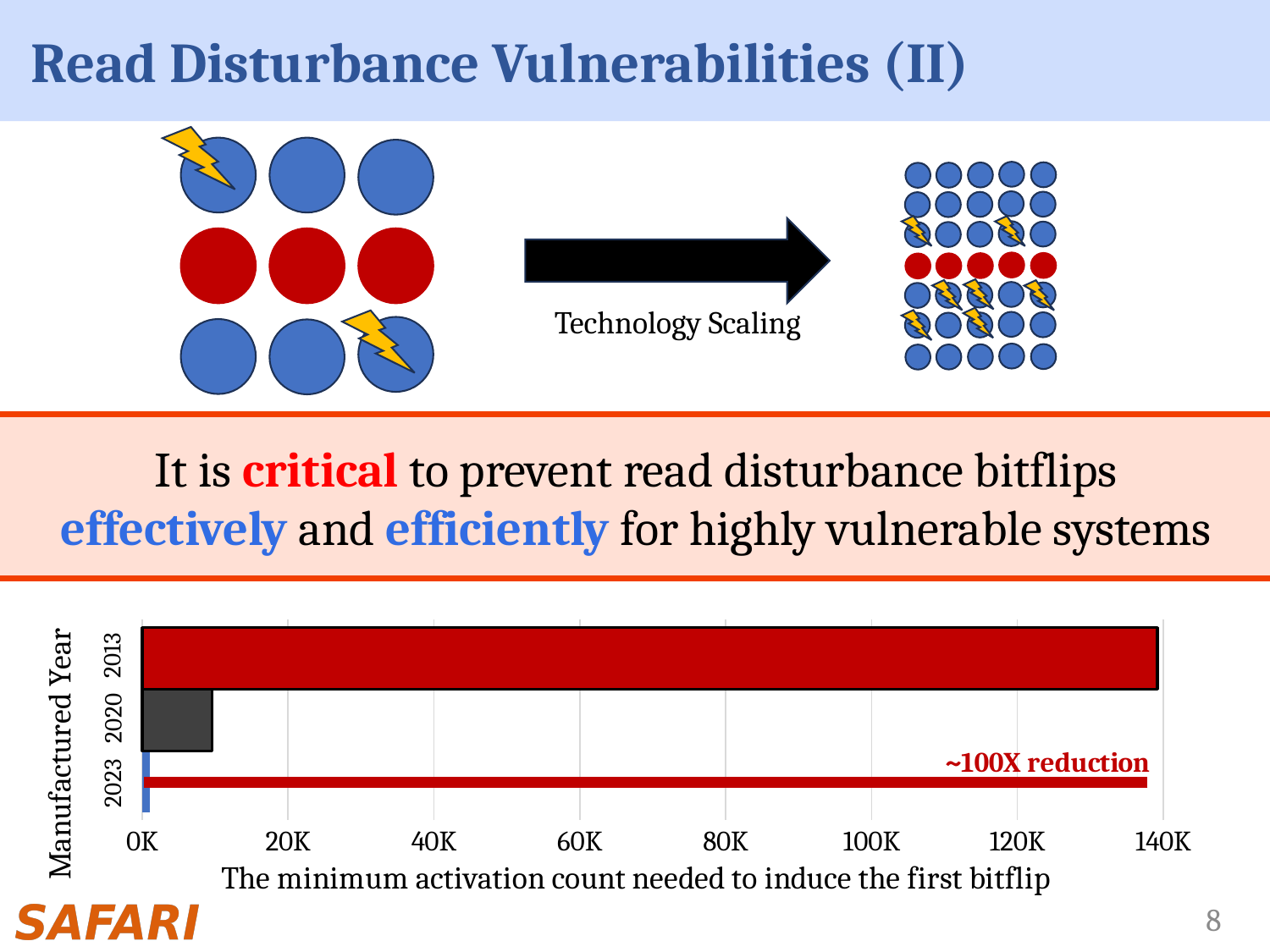
Is the minimum activation count for 2013 greater or less than 120K? greater Which manufactured year has the highest minimum activation count needed to induce the first bitflip? 2013 Which has a larger minimum activation count, 2020 or 2023? 2020 Which has a larger minimum activation count, 2013 or 2020? 2013 What reduction does the annotation on the bar chart state? ~100X reduction Does the minimum activation count rise or fall as the manufactured year goes from 2013 to 2023? fall Is the minimum activation count for 2023 greater or less than 20K? less Which manufactured year has the lowest minimum activation count needed to induce the first bitflip? 2023 What is the label of the horizontal axis of the bar chart? The minimum activation count needed to induce the first bitflip What kind of chart is shown at the bottom of the slide? bar chart How many manufactured years are plotted in the bar chart? 3 Is the minimum activation count for 2020 greater or less than 20K? less